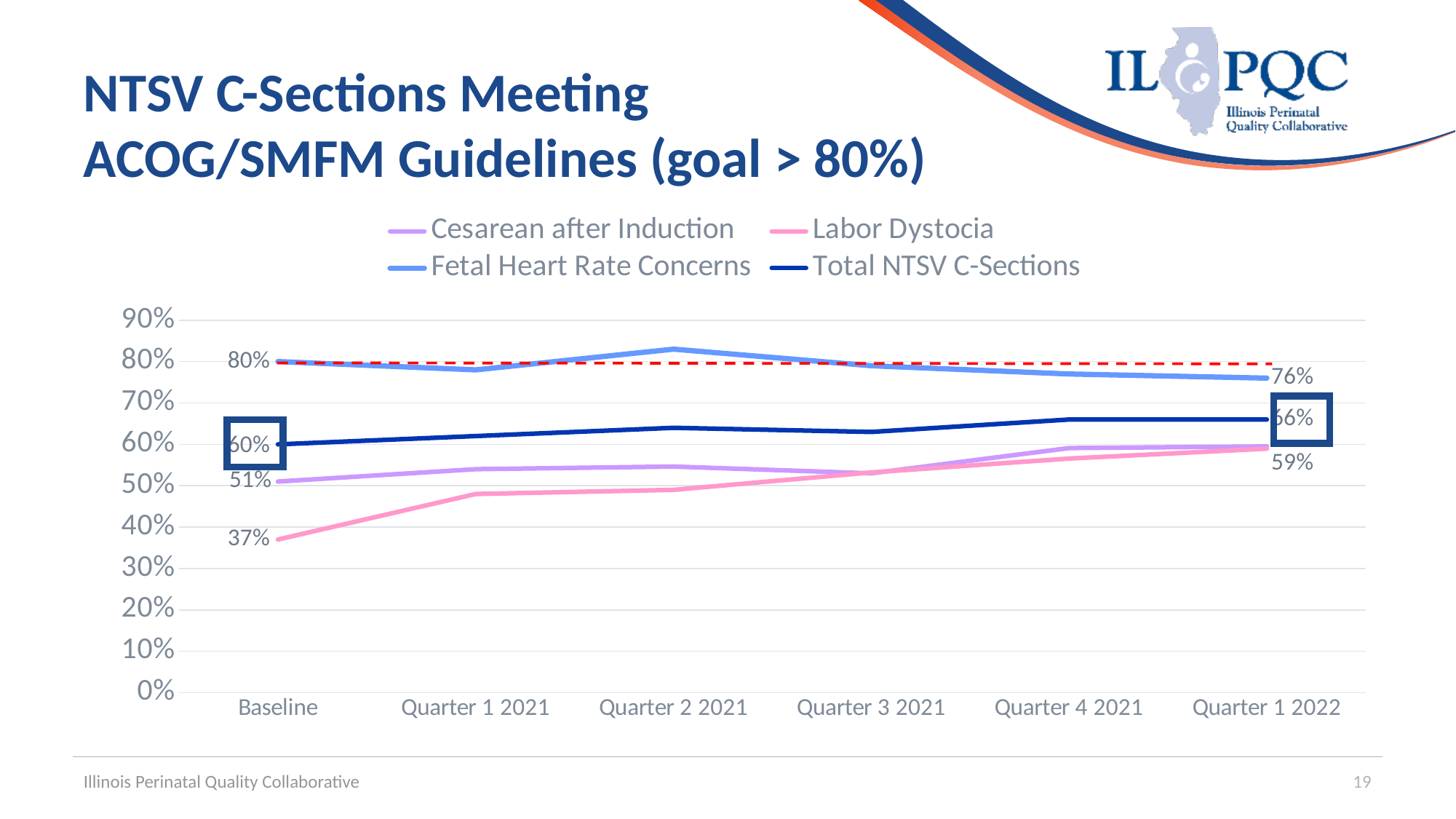
Is the value for Fetal Heart Rate Concerns at Quarter 2 2021 greater or less than 80%? greater What kind of chart is shown on the slide? line chart By how many percentage points did Total NTSV C-Sections change from Baseline to Quarter 1 2022? 6 percentage points Does the Labor Dystocia line rise or fall from Baseline to Quarter 1 2022? rise Which series has the lowest value at Baseline? Labor Dystocia What is the value for Total NTSV C-Sections at Baseline? 60% How many time points are shown along the x axis? 6 How many series does the legend list? 4 What is the value for Labor Dystocia at Baseline? 37% What is the value for Fetal Heart Rate Concerns at Baseline? 80% What is the value for Fetal Heart Rate Concerns at Quarter 1 2022? 76% What is the value for Total NTSV C-Sections at Quarter 1 2022? 66%